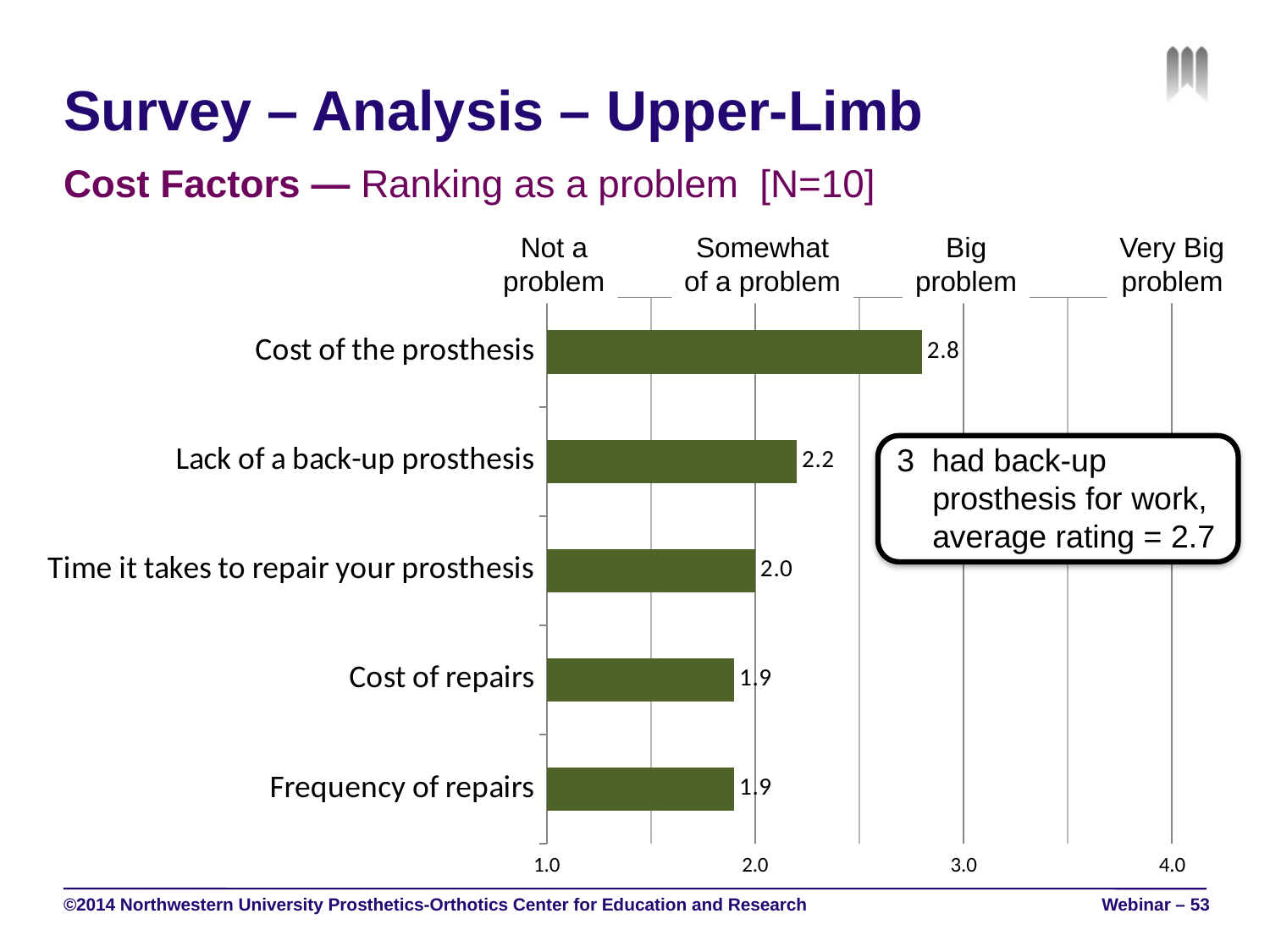
What is the value for Time it takes to repair your prosthesis? 2.0 Which cost factor has the highest rating? Cost of the prosthesis What is the value for Cost of the prosthesis? 2.8 Which is larger, the value for Lack of a back-up prosthesis or the value for Time it takes to repair your prosthesis? Lack of a back-up prosthesis What is the difference between the values for Time it takes to repair your prosthesis and Frequency of repairs? 0.1 What is the value for Cost of repairs? 1.9 What is the sample size (N) stated in the chart subtitle? 10 What kind of chart is shown on the slide? bar chart What is the difference between the values for Cost of the prosthesis and Lack of a back-up prosthesis? 0.6 How many cost factors are shown in the chart? 5 What is the value for Lack of a back-up prosthesis? 2.2 Is the value for Cost of the prosthesis greater or less than 3.0? less